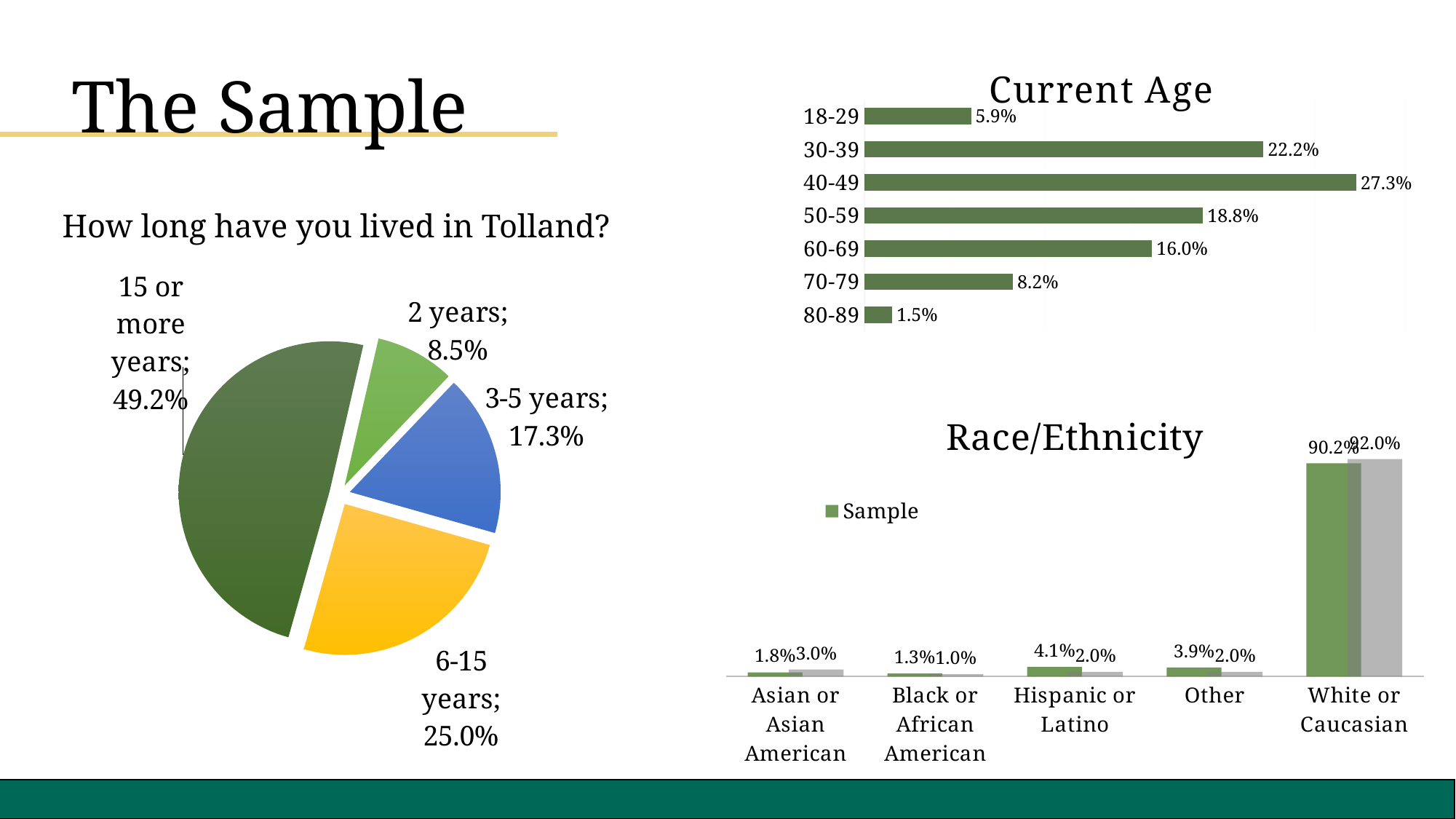
In the 'Current Age' chart, what is the value for the 40-49 age group? 27.3% In the 'Current Age' chart, which age group has the lowest value? 80-89 In the 'Race/Ethnicity' chart, what is the Sample value for Hispanic or Latino? 4.1% In the 'How long have you lived in Tolland?' chart, what is the value for 3-5 years? 17.3% In the 'Race/Ethnicity' chart, which is larger for the Sample series: Hispanic or Latino or Black or African American? Hispanic or Latino In the 'How long have you lived in Tolland?' chart, what share of respondents have lived in Tolland for 15 or more years? 49.2% What kind of chart is the 'Race/Ethnicity' chart? Bar chart In the 'Current Age' chart, which age group has the highest value? 40-49 How many age groups are shown in the 'Current Age' chart? 7 In the 'Current Age' chart, what is the difference between the values for 30-39 and 18-29? 16.3% What kind of chart is 'How long have you lived in Tolland?'? Pie chart In the 'How long have you lived in Tolland?' chart, which category has the smallest slice? 2 years